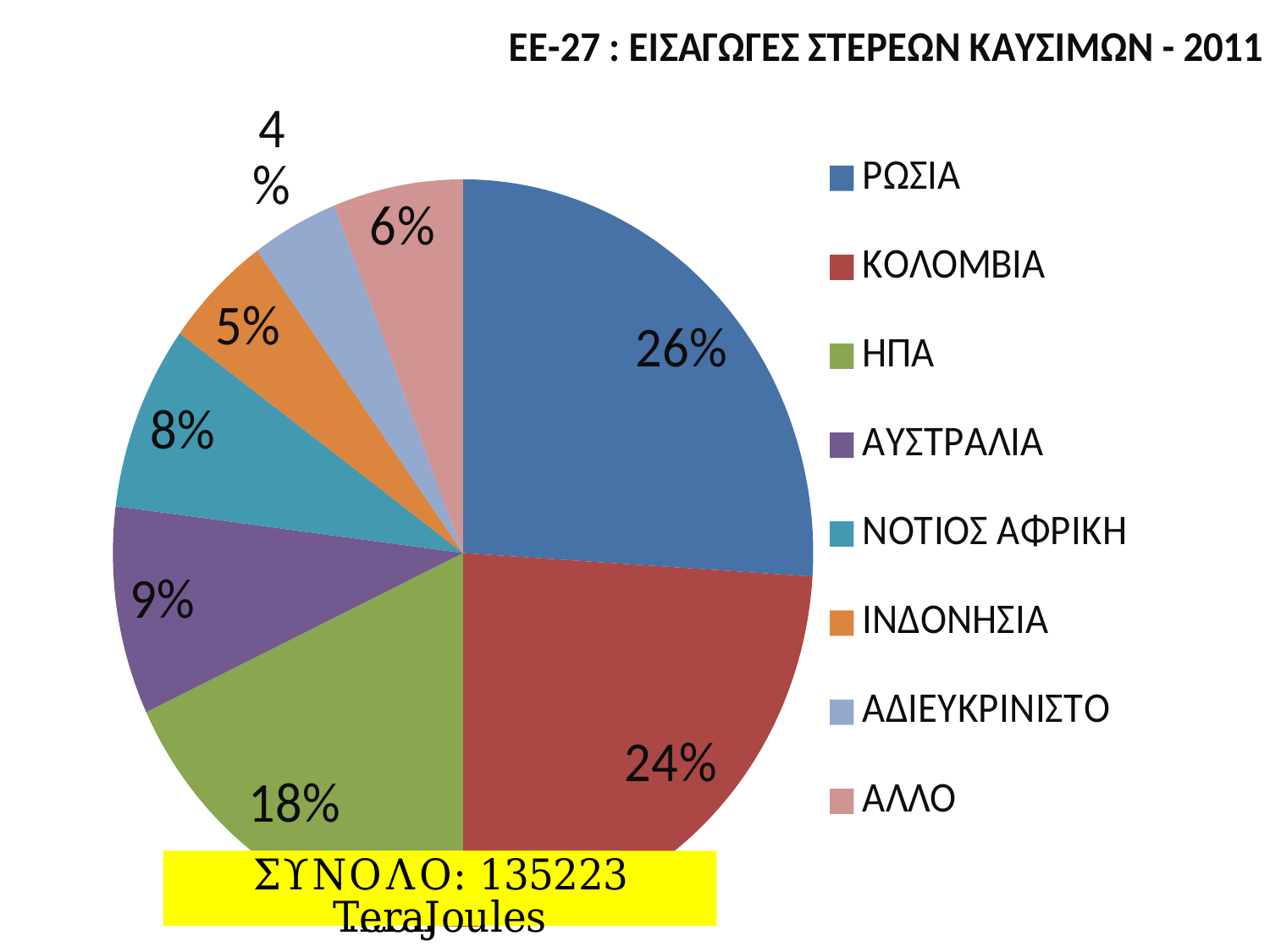
Which category has the largest slice of the pie? ΡΩΣΙΑ How many categories does the legend list? 8 What share of the pie does ΡΩΣΙΑ account for? 26% What kind of chart is shown on the slide? pie chart Which category has the smallest slice of the pie? ΑΔΙΕΥΚΡΙΝΙΣΤΟ What is the value shown for ΙΝΔΟΝΗΣΙΑ? 5% What is the title of the chart? ΕΕ-27 : ΕΙΣΑΓΩΓΕΣ ΣΤΕΡΕΩΝ ΚΑΥΣΙΜΩΝ - 2011 What is the value shown for ΝΟΤΙΟΣ ΑΦΡΙΚΗ? 8% What share of the pie does ΚΟΛΟΜΒΙΑ account for? 24% What is the value shown for ΗΠΑ? 18% Which is larger, the share for ΑΥΣΤΡΑΛΙΑ or the share for ΑΛΛΟ? ΑΥΣΤΡΑΛΙΑ What is the difference between the shares of ΡΩΣΙΑ and ΗΠΑ? 8%